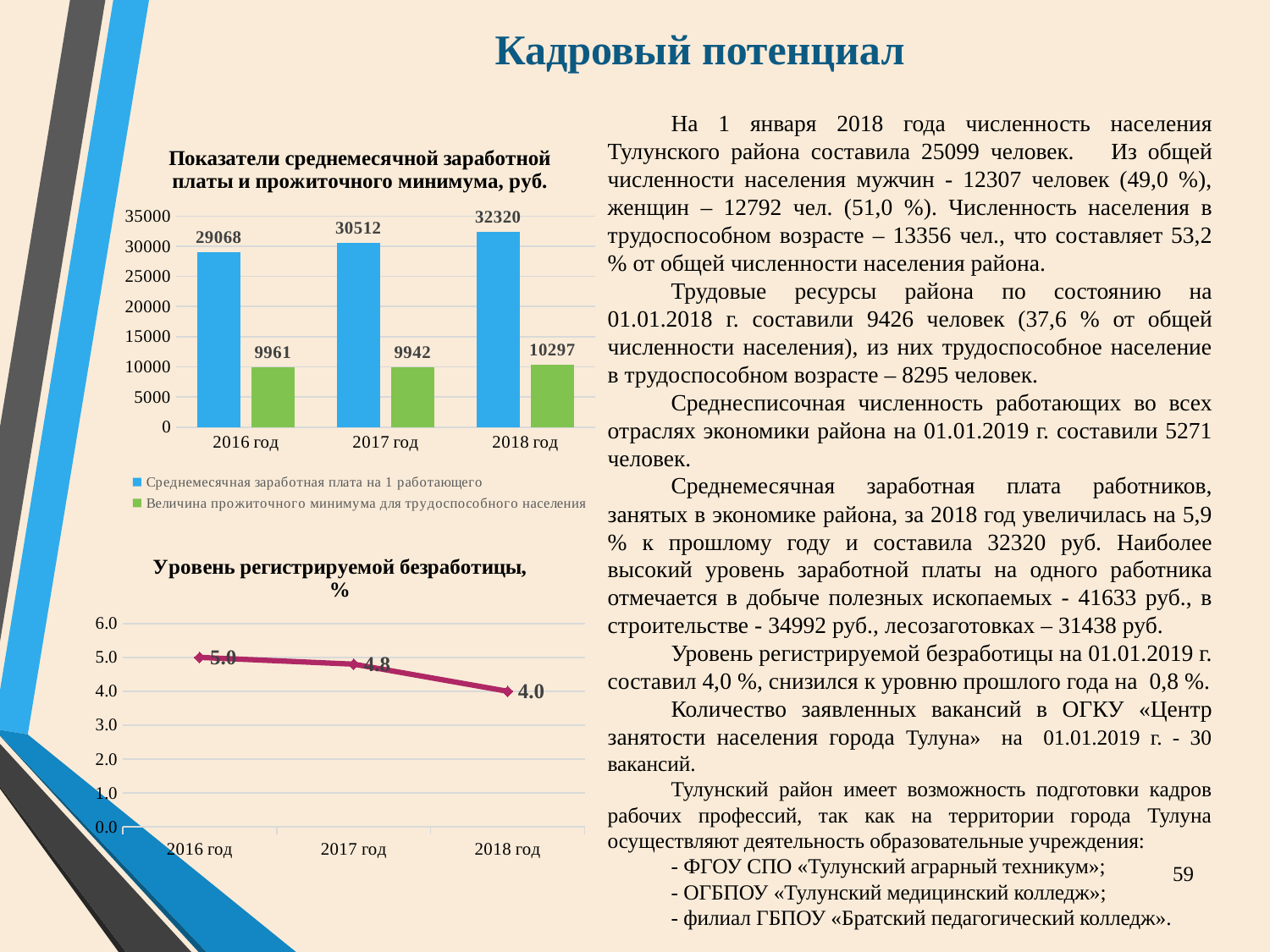
In the chart 'Показатели среднемесячной заработной платы и прожиточного минимума, руб.', which year has the lowest value for 'Величина прожиточного минимума для трудоспособного населения'? 2017 год In the chart 'Показатели среднемесячной заработной платы и прожиточного минимума, руб.', how many series does the legend list? 2 In the chart 'Показатели среднемесячной заработной платы и прожиточного минимума, руб.', what is the value of 'Среднемесячная заработная плата на 1 работающего' for 2018 год? 32320 What kind of chart is 'Уровень регистрируемой безработицы, %'? line chart What kind of chart is 'Показатели среднемесячной заработной платы и прожиточного минимума, руб.'? bar chart In the chart 'Уровень регистрируемой безработицы, %', what is the difference between the values for 2016 год and 2018 год? 1.0 In the chart 'Показатели среднемесячной заработной платы и прожиточного минимума, руб.', what is the difference between the 'Среднемесячная заработная плата на 1 работающего' values for 2018 год and 2017 год? 1808 In the chart 'Уровень регистрируемой безработицы, %', what is the value for 2017 год? 4.8 In the chart 'Показатели среднемесячной заработной платы и прожиточного минимума, руб.', does 'Среднемесячная заработная плата на 1 работающего' rise or fall from 2016 год to 2018 год? rise In the chart 'Показатели среднемесячной заработной платы и прожиточного минимума, руб.', which year has the highest value for 'Среднемесячная заработная плата на 1 работающего'? 2018 год In the chart 'Показатели среднемесячной заработной платы и прожиточного минимума, руб.', what is the value of 'Величина прожиточного минимума для трудоспособного населения' for 2017 год? 9942 In the chart 'Уровень регистрируемой безработицы, %', which year has the lowest value? 2018 год